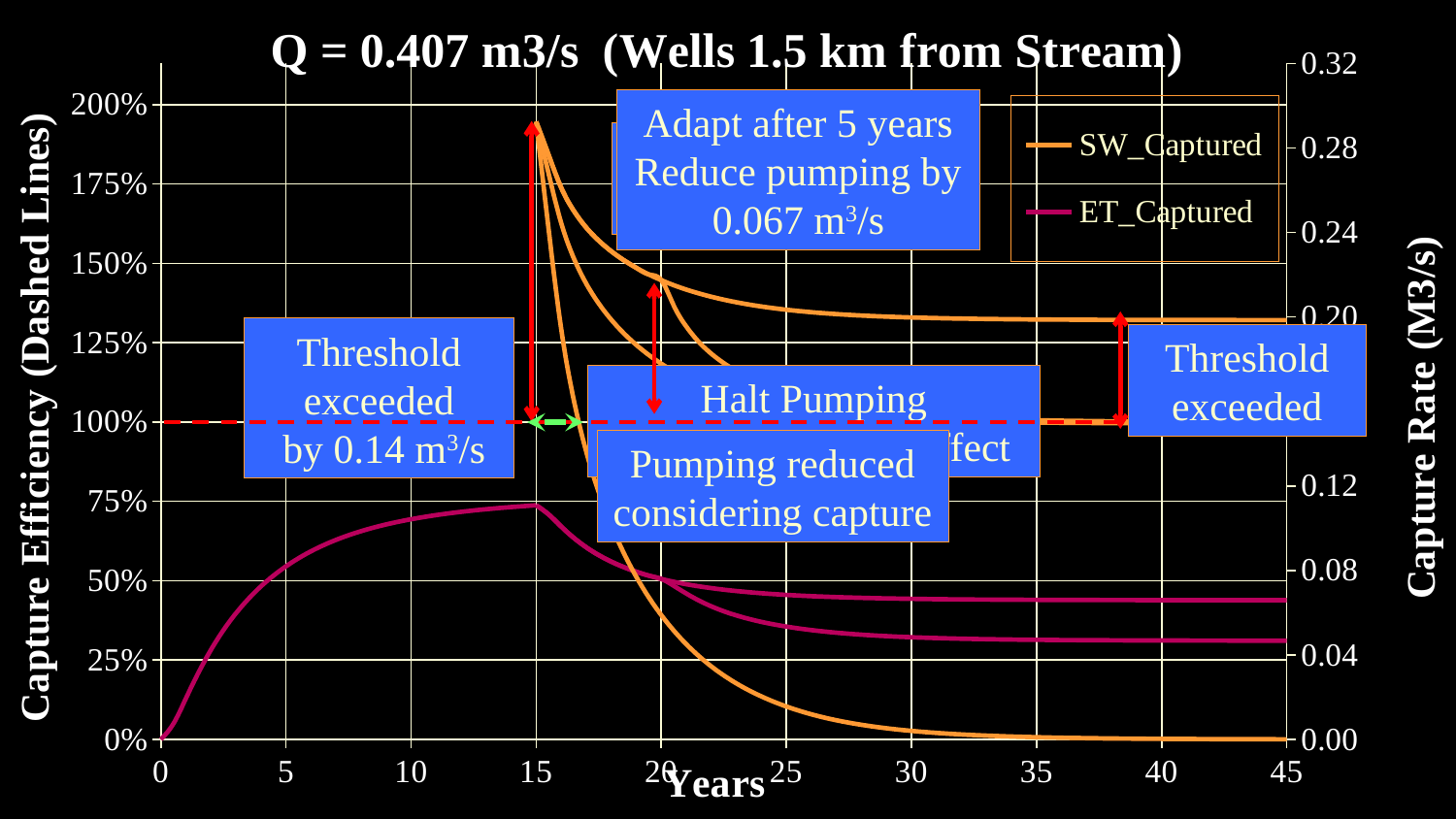
Does the ET_Captured curve rise or fall between year 0 and year 15? rise What is the last value shown on the Years axis? 45 Does the lowest SW_Captured curve rise or fall between year 15 and year 45? fall Which series reaches the higher value at year 15, SW_Captured or ET_Captured? SW_Captured What is the highest value shown on the right-hand Capture Rate axis? 0.32 How many series does the legend list? 2 What are the two series named in the legend? SW_Captured and ET_Captured What kind of chart is shown on the slide? line chart Is the peak value of the SW_Captured curve at year 15 greater or less than 150% on the left axis? greater At what capture efficiency level is the horizontal red dashed threshold line drawn? 100% Is the peak value of the ET_Captured curve at year 15 greater or less than 100% on the left axis? less What is the title of the chart? Q = 0.407 m3/s (Wells 1.5 km from Stream)